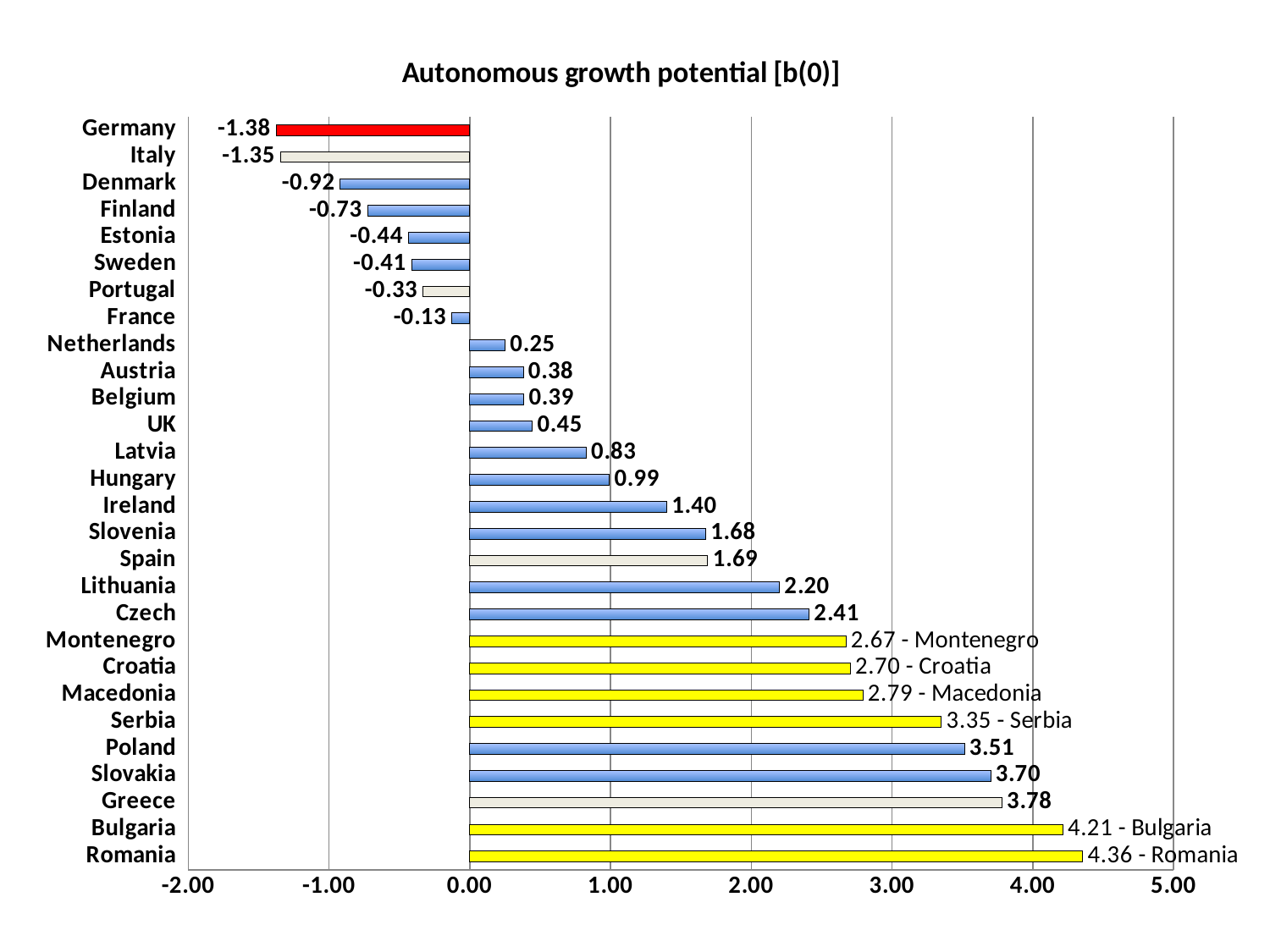
Which country has the lowest autonomous growth potential? Germany What is the difference between the values for Romania and Germany? 5.74 What is the title of the chart? Autonomous growth potential [b(0)] What is the difference between the values for Greece and Poland? 0.27 What type of chart is shown on the slide? Bar chart What is the value shown for Hungary? 0.99 What is the autonomous growth potential value for Germany? -1.38 Which has a larger value, Denmark or Finland? Finland Which has a larger value, Slovakia or Czech? Slovakia Which country has the highest autonomous growth potential? Romania How many countries are shown in the chart? 28 What is the value shown for Serbia? 3.35